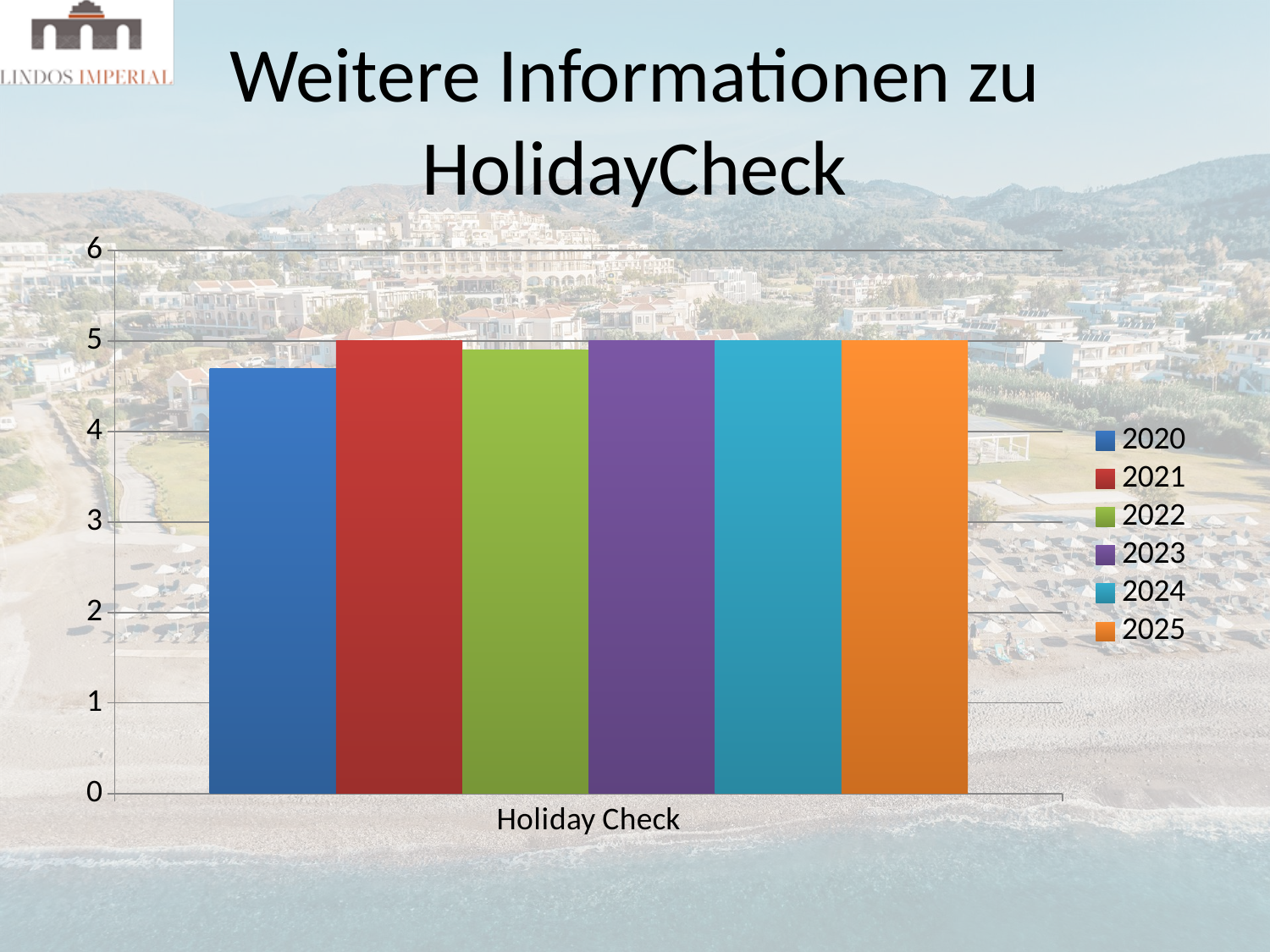
Which series has the lowest value for Holiday Check? 2020 What is the value for 2021? 5 How many categories are shown on the x axis? 1 Which legend entry is shown in orange? 2025 Which is larger, the value for 2020 or the value for 2021? 2021 Which is larger, the value for 2020 or the value for 2025? 2025 How many series does the legend list? 6 Is the value for 2020 greater or less than 4? greater What is the label of the category on the x axis? Holiday Check What is the value for 2025? 5 What kind of chart is shown on the slide? bar chart Is the value for 2020 greater or less than 5? less